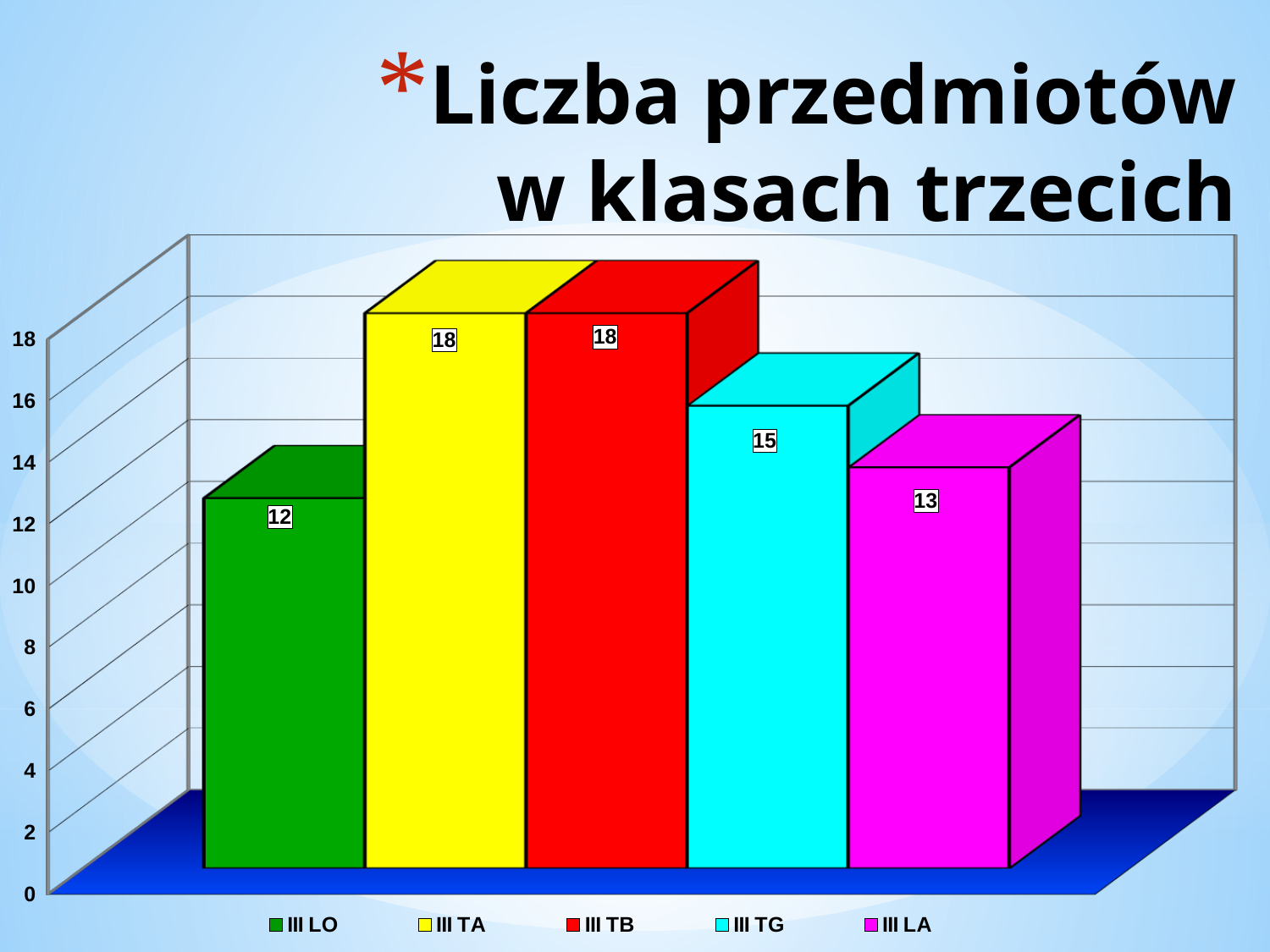
What is the difference between the values for III TB and III LA? 5 Which is larger, the value for III TG or the value for III LO? III TG What is the value for III TG? 15 What is the value for III LO? 12 What is the highest value shown on the chart? 18 Which class has the lowest value? III LO What kind of chart is shown on the slide? bar chart What is the value for III TA? 18 What is the value for III LA? 13 How many entries does the legend list? 5 What is the title of the slide? Liczba przedmiotów w klasach trzecich How many bars are shown on the chart? 5